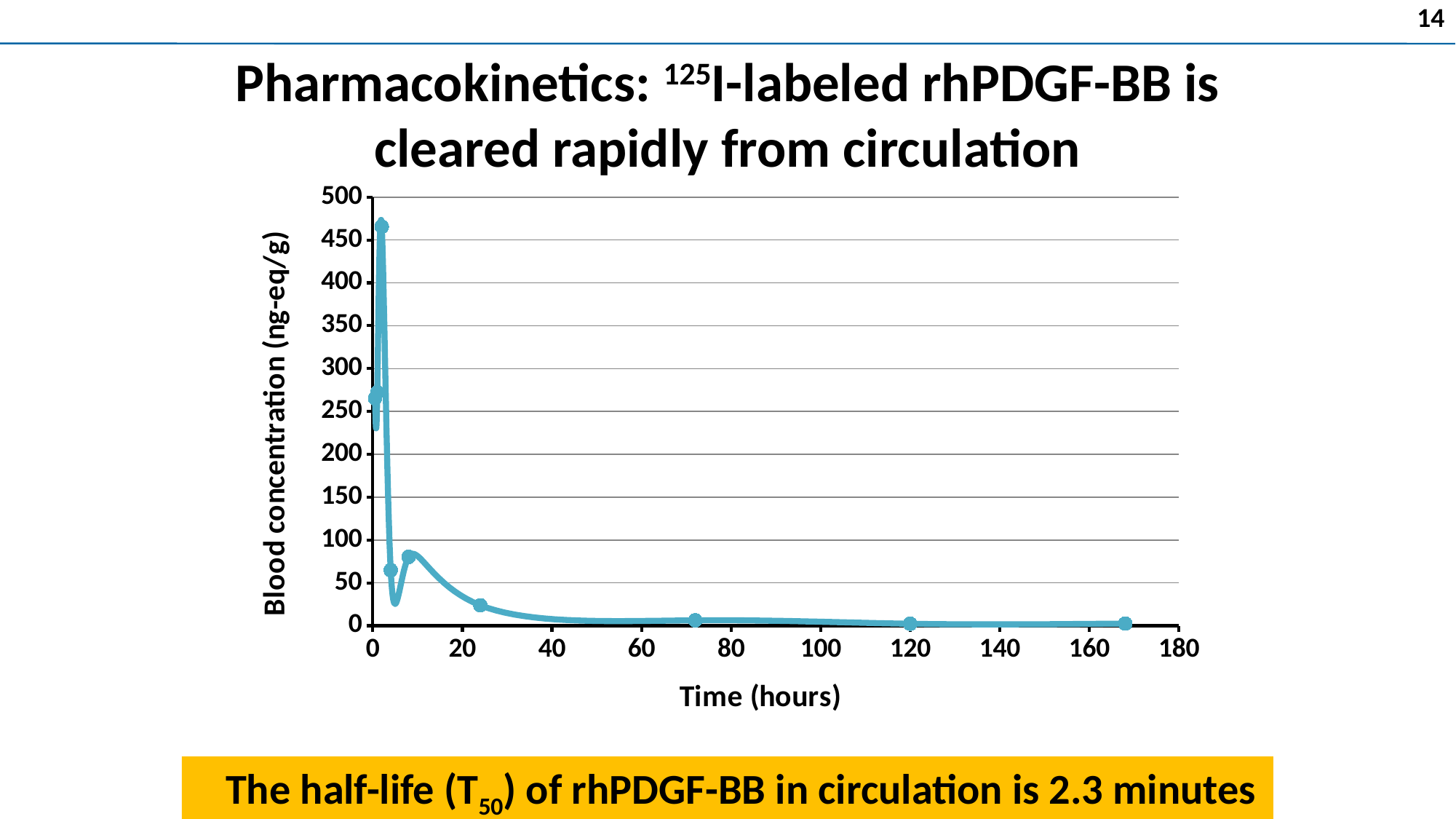
What kind of chart is shown on the slide? line chart Is the blood concentration at 72 hours greater or less than 50? less Is the blood concentration at 24 hours greater or less than 50? less After the peak, do the blood concentration values rise or fall as time increases? fall Is the blood concentration at 120 hours greater or less than 50? less Does the peak blood concentration occur before or after 20 hours? before What is the title of the chart's y axis? Blood concentration (ng-eq/g) Which is larger, the blood concentration at 24 hours or at 120 hours? 24 hours What is the title of the chart's x axis? Time (hours) What is the maximum value shown on the y axis? 500